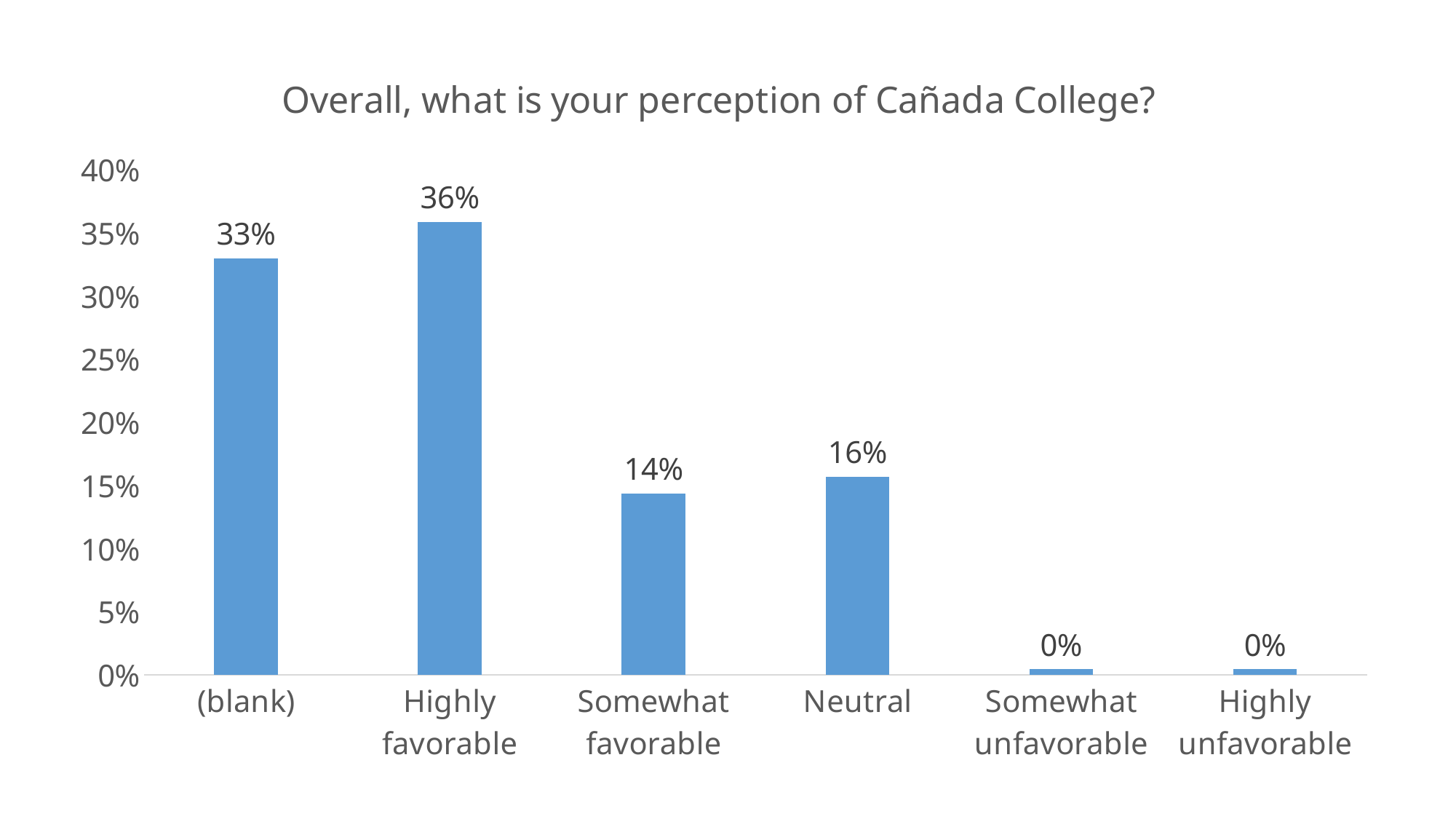
How many categories are shown on the x axis? 6 What is the value for Neutral? 16% What is the title of the chart? Overall, what is your perception of Cañada College? Is the value for (blank) greater or less than 30%? greater What is the value for Highly favorable? 36% What is the value for (blank)? 33% Which is larger, Neutral or Somewhat favorable? Neutral Which category has the highest value? Highly favorable What is the difference between (blank) and Neutral? 17% What kind of chart is this? bar chart What is the difference between Highly favorable and Somewhat favorable? 22% What is the value for Somewhat favorable? 14%